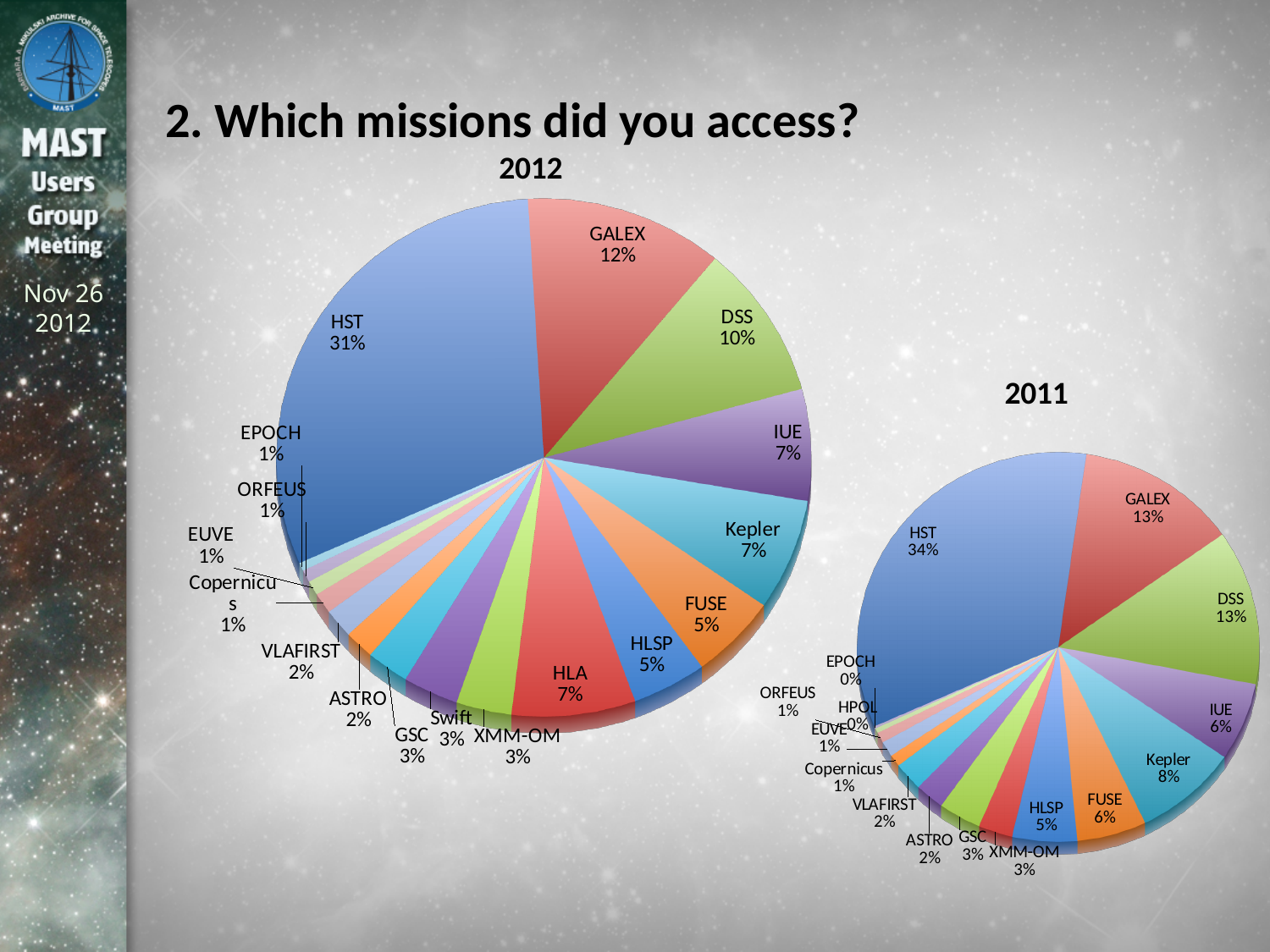
What is the title of the slide? 2. Which missions did you access? In the 2011 pie chart, what percentage is shown for Kepler? 8% In the 2012 pie chart, what share of access does HST have? 31% In the 2012 pie chart, what is the difference between the HST share and the GALEX share? 19% In the 2011 pie chart, what share of access does HST have? 34% In the 2012 pie chart, what is the difference between the DSS share and the IUE share? 3% In the 2012 pie chart, which mission has the largest share? HST In the 2011 pie chart, what percentage is shown for DSS? 13% In the 2011 pie chart, which mission has the largest share? HST In the 2012 pie chart, what percentage is shown for GALEX? 12% What kind of chart is used to show the 2012 data? Pie chart In the 2011 pie chart, which is larger, the share for Kepler or the share for IUE? Kepler